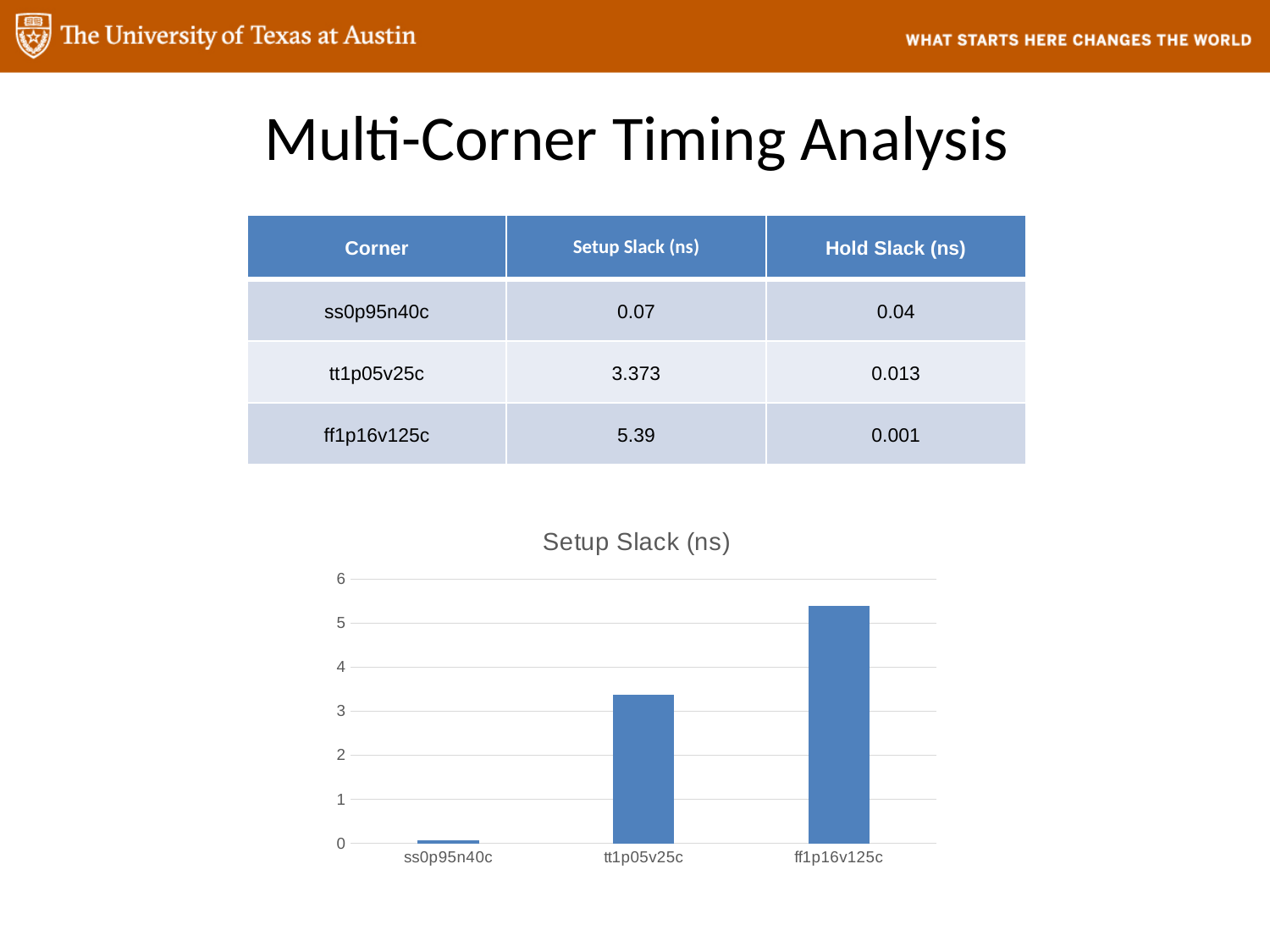
Which corner has the lowest setup slack in the chart? ss0p95n40c Which corner has the highest setup slack in the chart? ff1p16v125c Is the setup slack for tt1p05v25c greater or less than 4? less What type of chart is shown on the slide? bar chart What is the title of the chart? Setup Slack (ns) What is the setup slack for tt1p05v25c? 3.373 Do the setup slack values rise or fall from left to right across the corners? rise Is the setup slack for ff1p16v125c greater or less than 5? greater What is the setup slack for ff1p16v125c? 5.39 What is the setup slack for ss0p95n40c? 0.07 Which has a larger setup slack, tt1p05v25c or ff1p16v125c? ff1p16v125c How many corners (categories) are plotted in the chart? 3